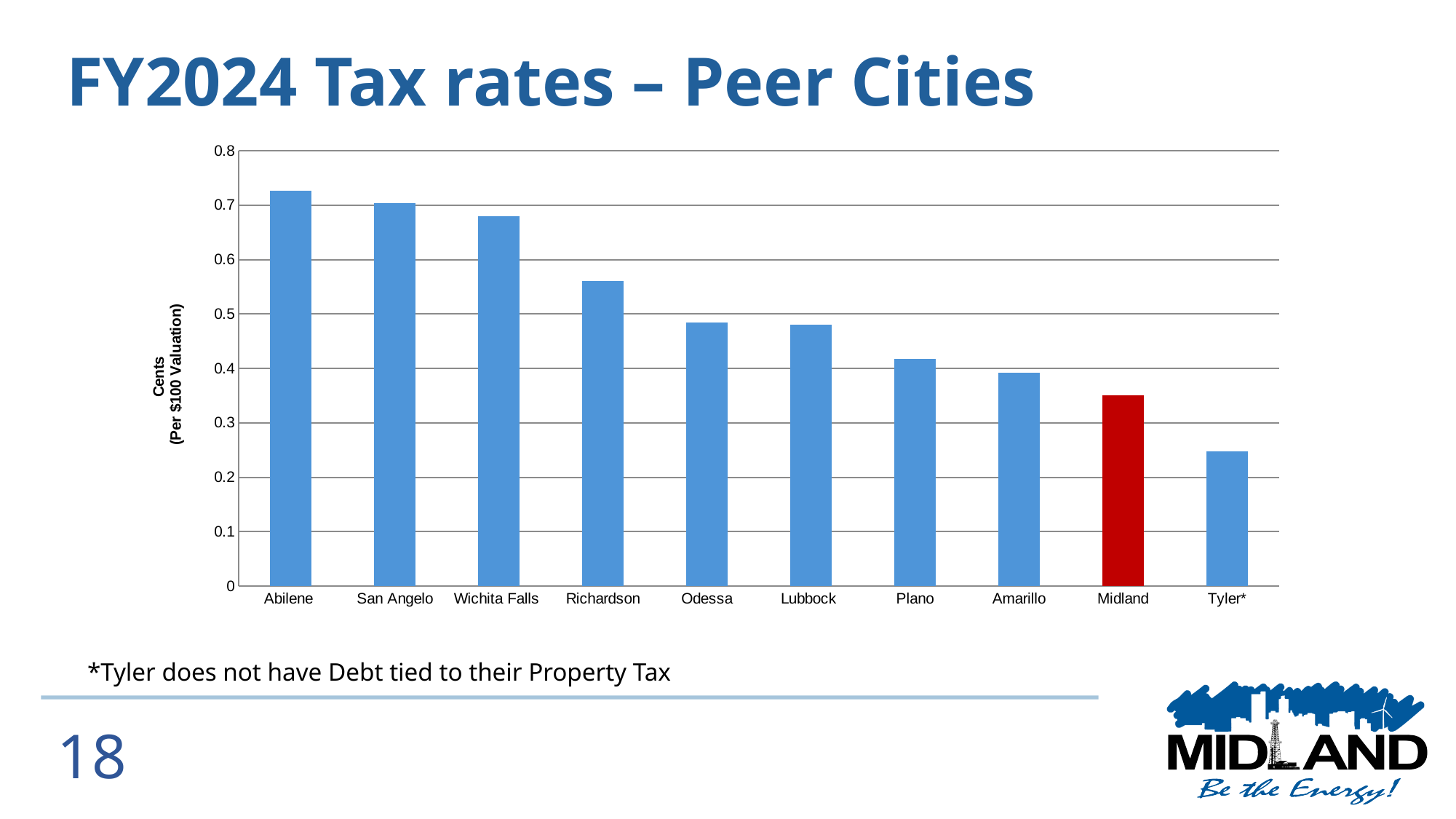
Which city has the highest tax rate in the chart? Abilene Which city has the lowest tax rate in the chart? Tyler* Is the value for Wichita Falls greater or less than 0.7? less How many cities are shown on the x axis of the chart? 10 Which has a higher tax rate, Plano or Midland? Plano Do the values rise or fall moving from left to right along the x axis? fall Is the value for Tyler* greater or less than 0.3? less Is the value for Abilene greater or less than 0.7? greater Which city's bar is coloured red in the chart? Midland What kind of chart is shown on the slide? bar chart